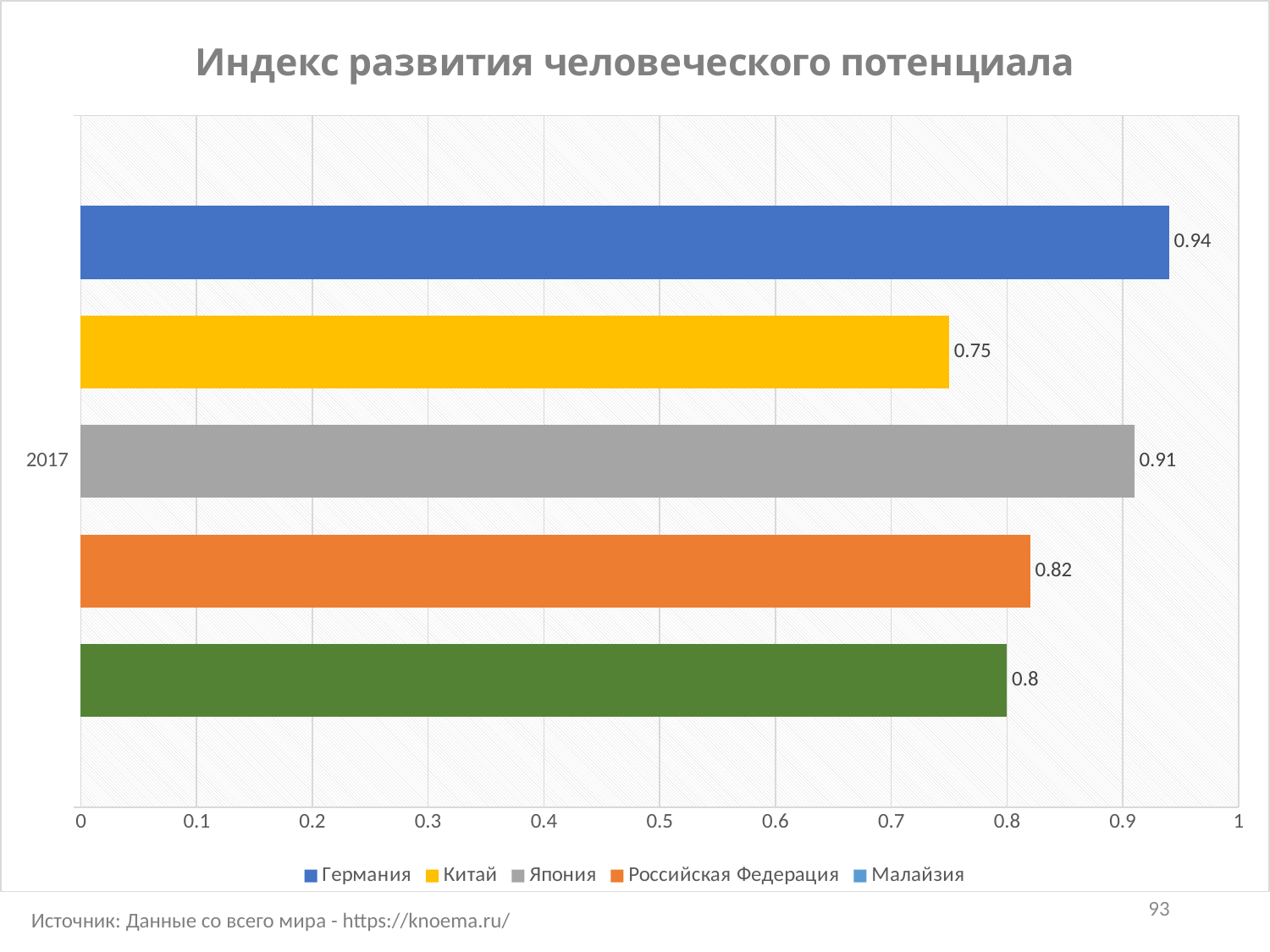
What is the value for Российская Федерация? 0.82 What is the title of the chart? Индекс развития человеческого потенциала How many series does the legend list? 5 What is the value for Япония? 0.91 What kind of chart is shown on the slide? bar chart Which series has the highest value? Германия Which is larger, the value for Япония or the value for Российская Федерация? Япония Which series has the lowest value? Китай What is the value for Малайзия? 0.8 What is the value for Германия? 0.94 What is the value for Китай? 0.75 What is the difference between the values for Германия and Китай? 0.19